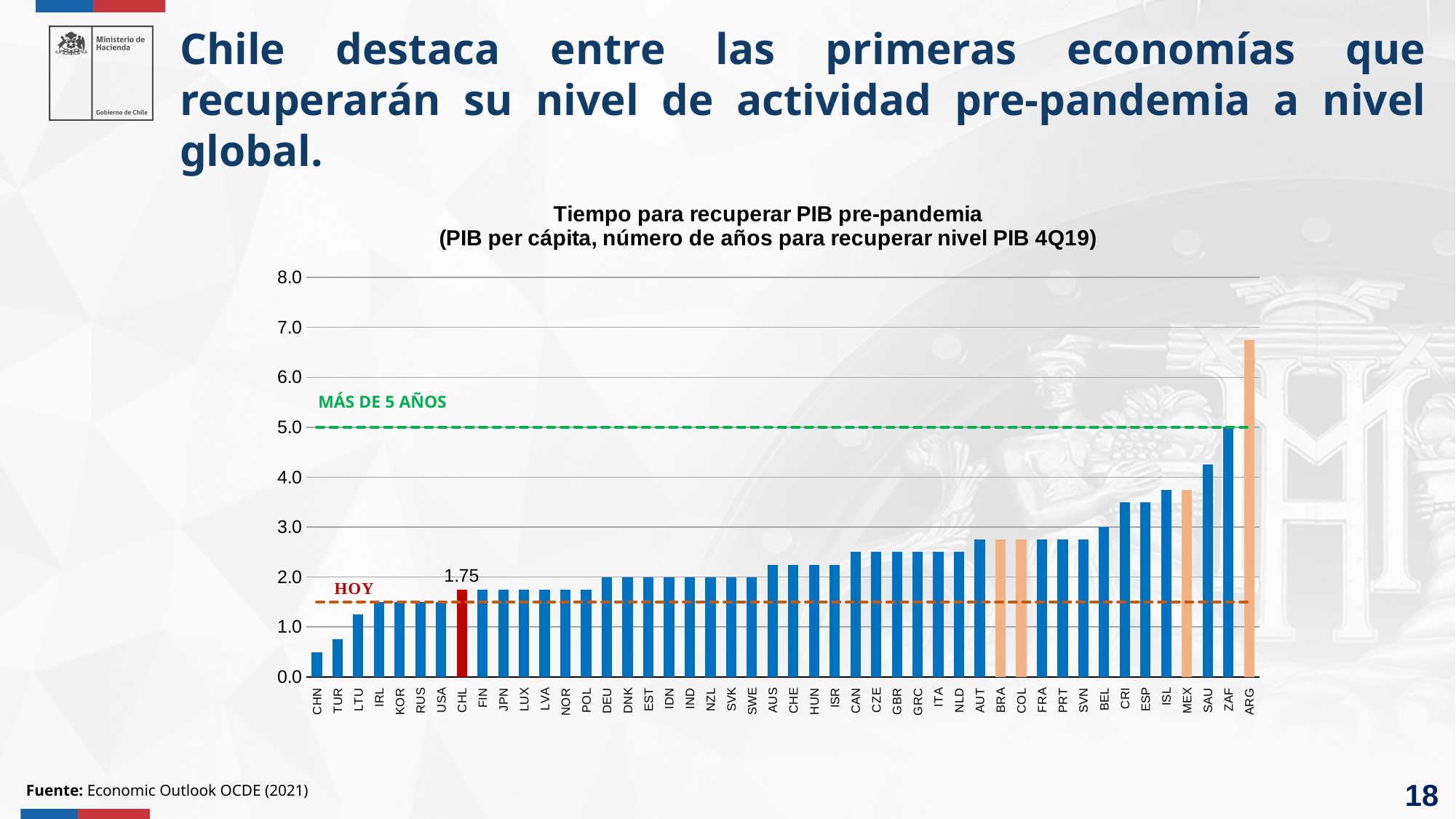
Which country has the lowest value in the chart? CHN What is the title of the chart? Tiempo para recuperar PIB pre-pandemia (PIB per cápita, número de años para recuperar nivel PIB 4Q19) Which is larger, the value for CHN or the value for TUR? TUR What type of chart is shown on the slide? bar chart Which country has the highest value in the chart? ARG Is the value for ARG greater or less than 6.0? greater Do the bar values generally rise or fall from left to right along the x axis? rise Is the value for CHN greater or less than 1.0? less Is the value for SAU greater or less than 4.0? greater How many countries are shown on the x axis of the chart? 46 What is the value shown for CHL? 1.75 Which is larger, the value for ARG or the value for SAU? ARG